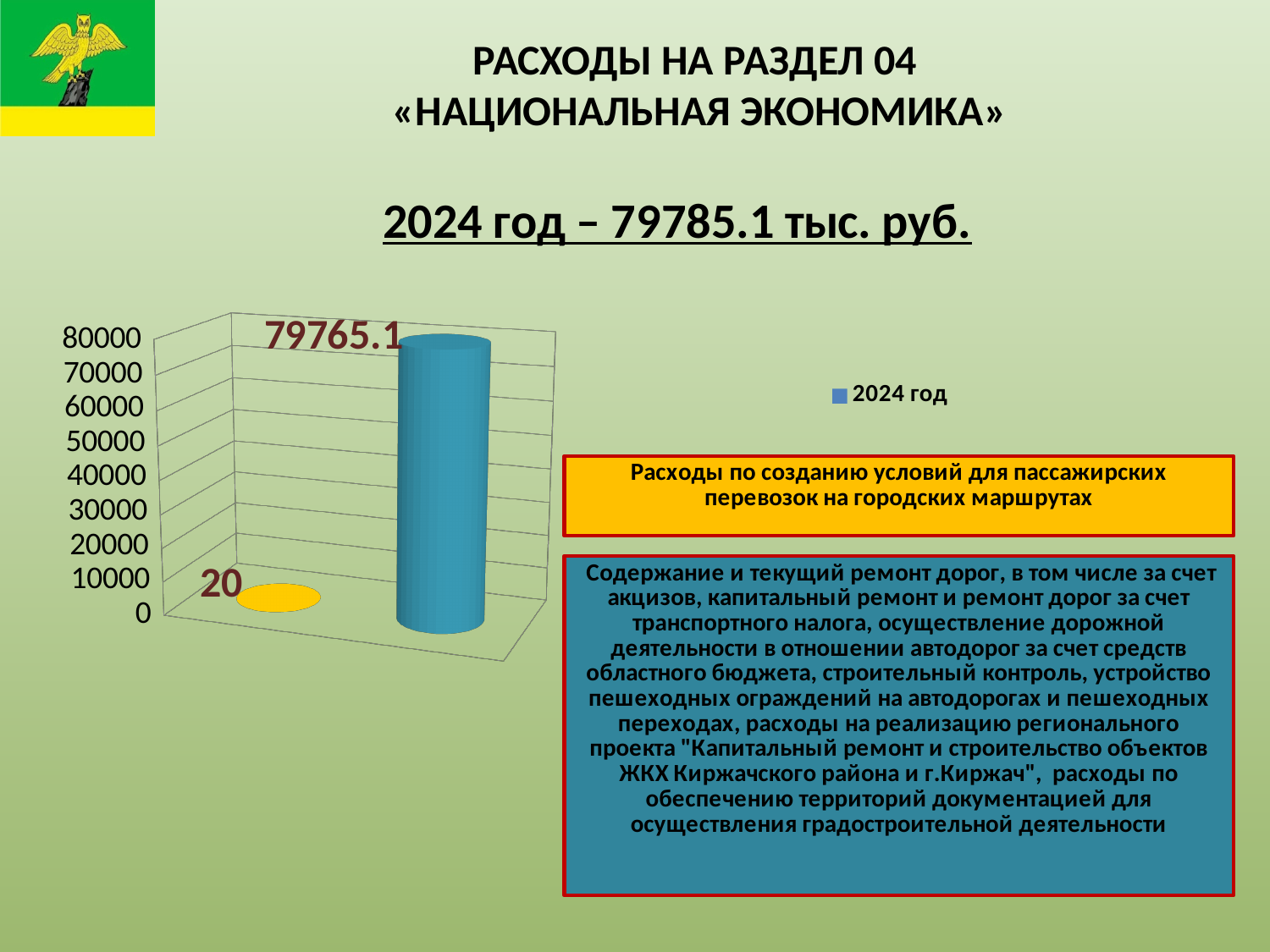
What is the legend entry of the chart? 2024 год Which bar in the chart is the lowest, the blue one or the yellow one? the yellow one Which bar in the chart is the highest, the blue one or the yellow one? the blue one What value is labelled on the yellow bar in the chart? 20 What kind of chart is shown on the slide? bar chart How many entries does the chart legend list? 1 What is the highest tick value shown on the vertical axis of the chart? 80000 How many bars are plotted in the chart? 2 What value is labelled on the blue bar in the chart? 79765.1 Is the value of the yellow bar greater or less than 10000? less Is the value of the blue bar greater or less than 70000? greater What is the difference between the values of the blue bar and the yellow bar in the chart? 79745.1